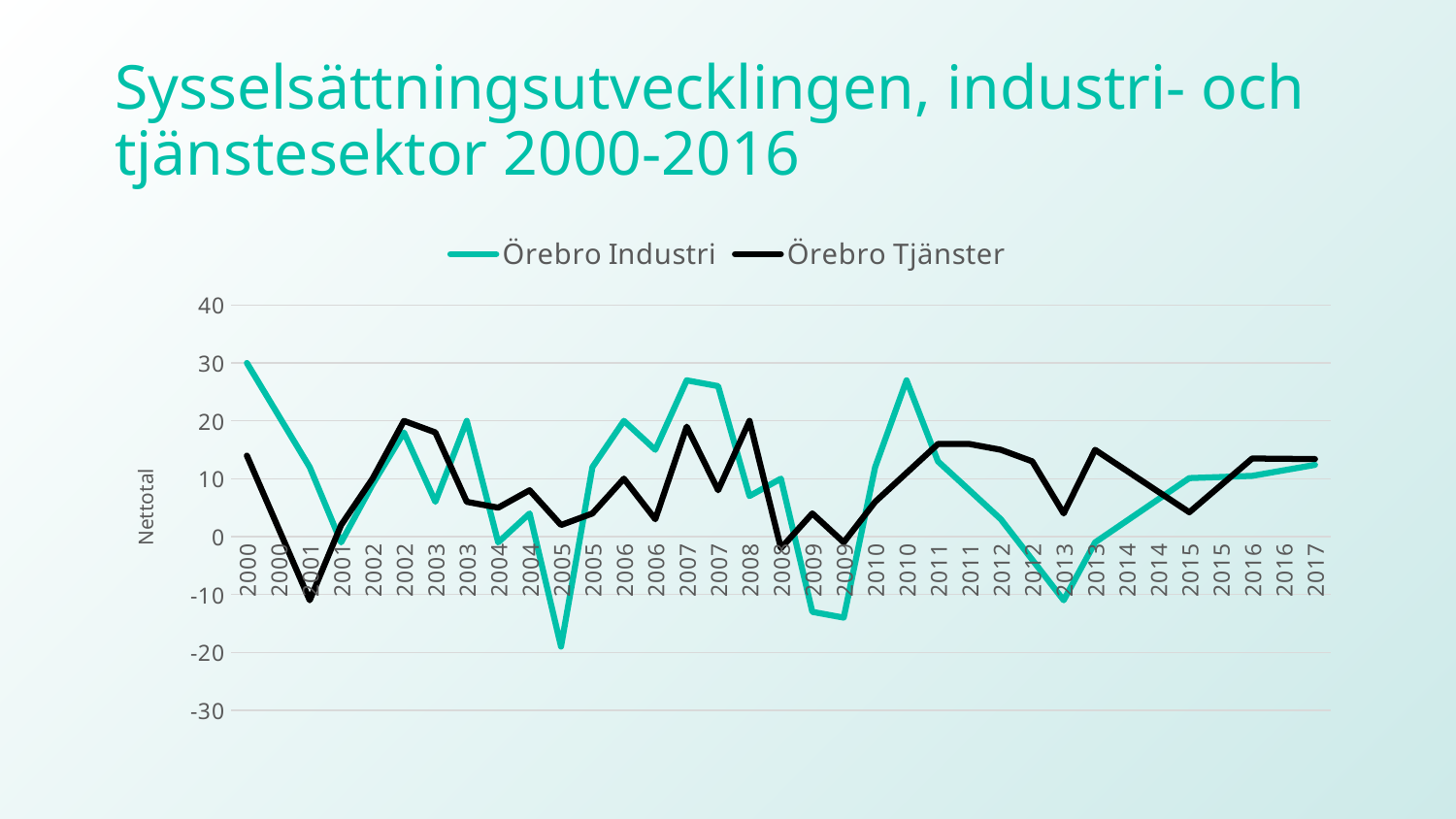
Is the value for Örebro Industri at the first 2000 point greater or less than 20? greater What is the highest value shown on the vertical axis? 40 What is the label on the vertical axis? Nettotal What kind of chart is shown on the slide? line chart Which series reaches the lowest value anywhere on the chart? Örebro Industri What are the two series named in the legend? Örebro Industri and Örebro Tjänster Is the value for Örebro Tjänster at 2017 greater or less than 10? greater Is the lowest value for Örebro Tjänster (in 2001) greater or less than 0? less In which year does Örebro Industri reach its highest value? 2000 Which series has the higher value at the first 2000 point? Örebro Industri How many series does the legend list? 2